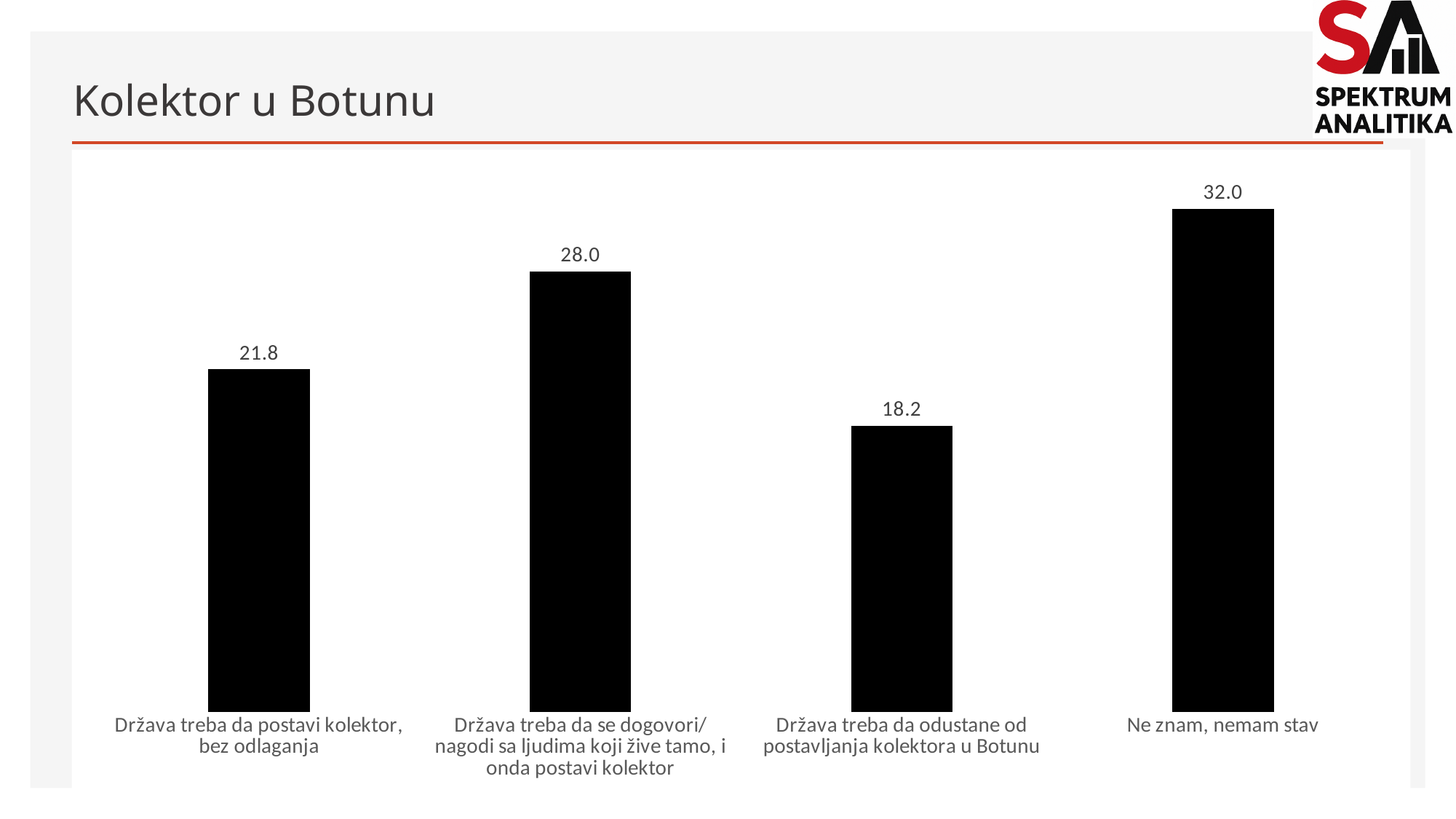
What kind of chart is shown on the slide? Bar chart What is the difference between the values for "Država treba da se dogovori/ nagodi sa ljudima koji žive tamo, i onda postavi kolektor" and "Država treba da postavi kolektor, bez odlaganja"? 6.2 What is the difference between the values for "Ne znam, nemam stav" and "Država treba da odustane od postavljanja kolektora u Botunu"? 13.8 How many categories are shown in the chart? 4 What is the value for "Država treba da postavi kolektor, bez odlaganja"? 21.8 What is the value for "Država treba da odustane od postavljanja kolektora u Botunu"? 18.2 What is the value for "Država treba da se dogovori/ nagodi sa ljudima koji žive tamo, i onda postavi kolektor"? 28.0 What is the value for "Ne znam, nemam stav"? 32.0 Which category has the highest value? Ne znam, nemam stav Which is larger: the value for "Država treba da postavi kolektor, bez odlaganja" or the value for "Država treba da se dogovori/ nagodi sa ljudima koji žive tamo, i onda postavi kolektor"? Država treba da se dogovori/ nagodi sa ljudima koji žive tamo, i onda postavi kolektor Which category has the lowest value? Država treba da odustane od postavljanja kolektora u Botunu What is the title of the slide? Kolektor u Botunu